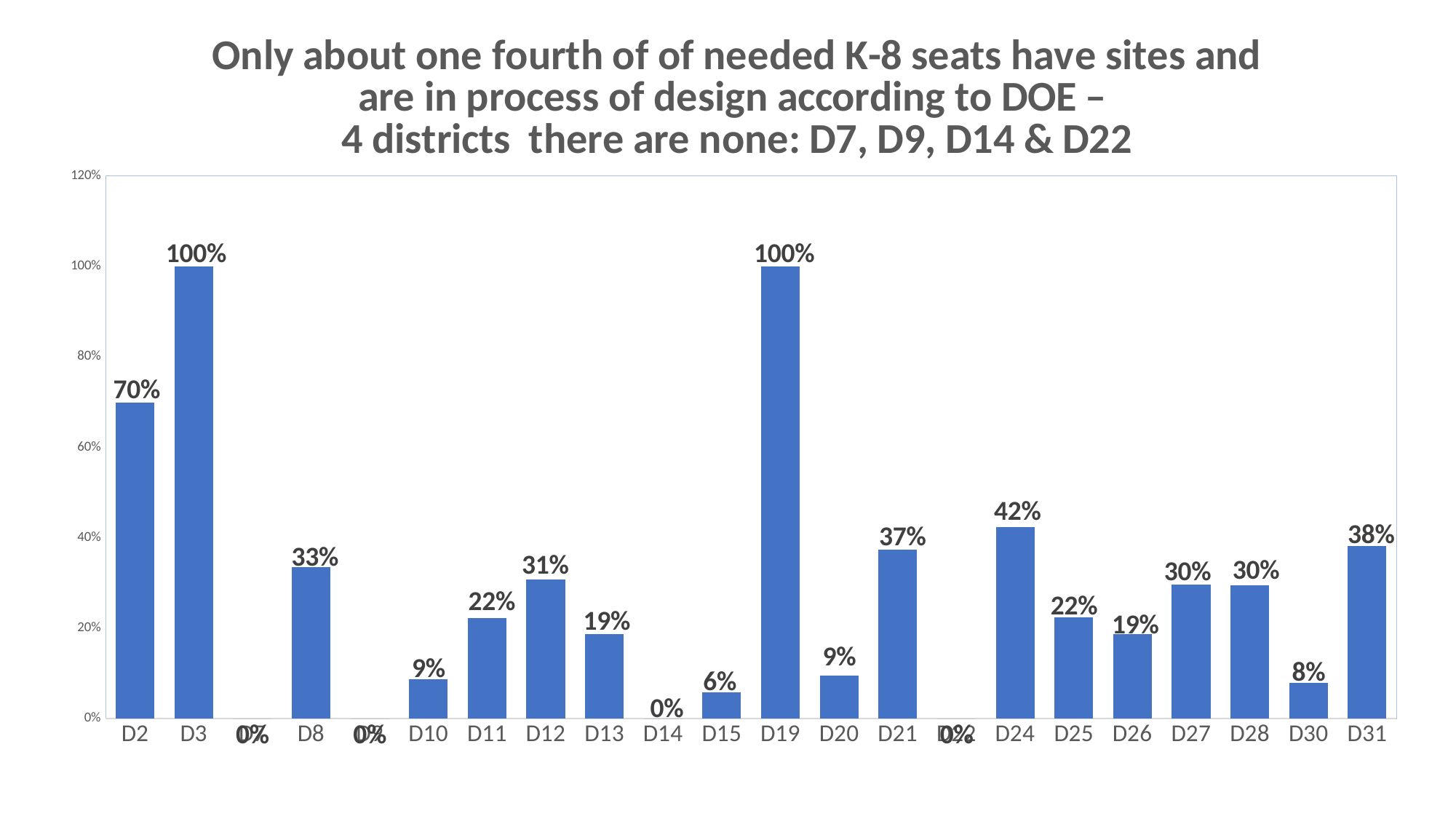
Is the value for D20 greater or less than 20%? less What is the value for D31? 38% What is the highest value shown on the chart? 100% What is the value for D24? 42% Which has a larger value, D27 or D31? D31 What is the difference between the values for D2 and D8? 37% What kind of chart is shown on the slide? bar chart What is the value for D14? 0% What is the value for D2? 70% What is the value for D15? 6% What is the difference between the values for D24 and D21? 5% What is the value for D12? 31%